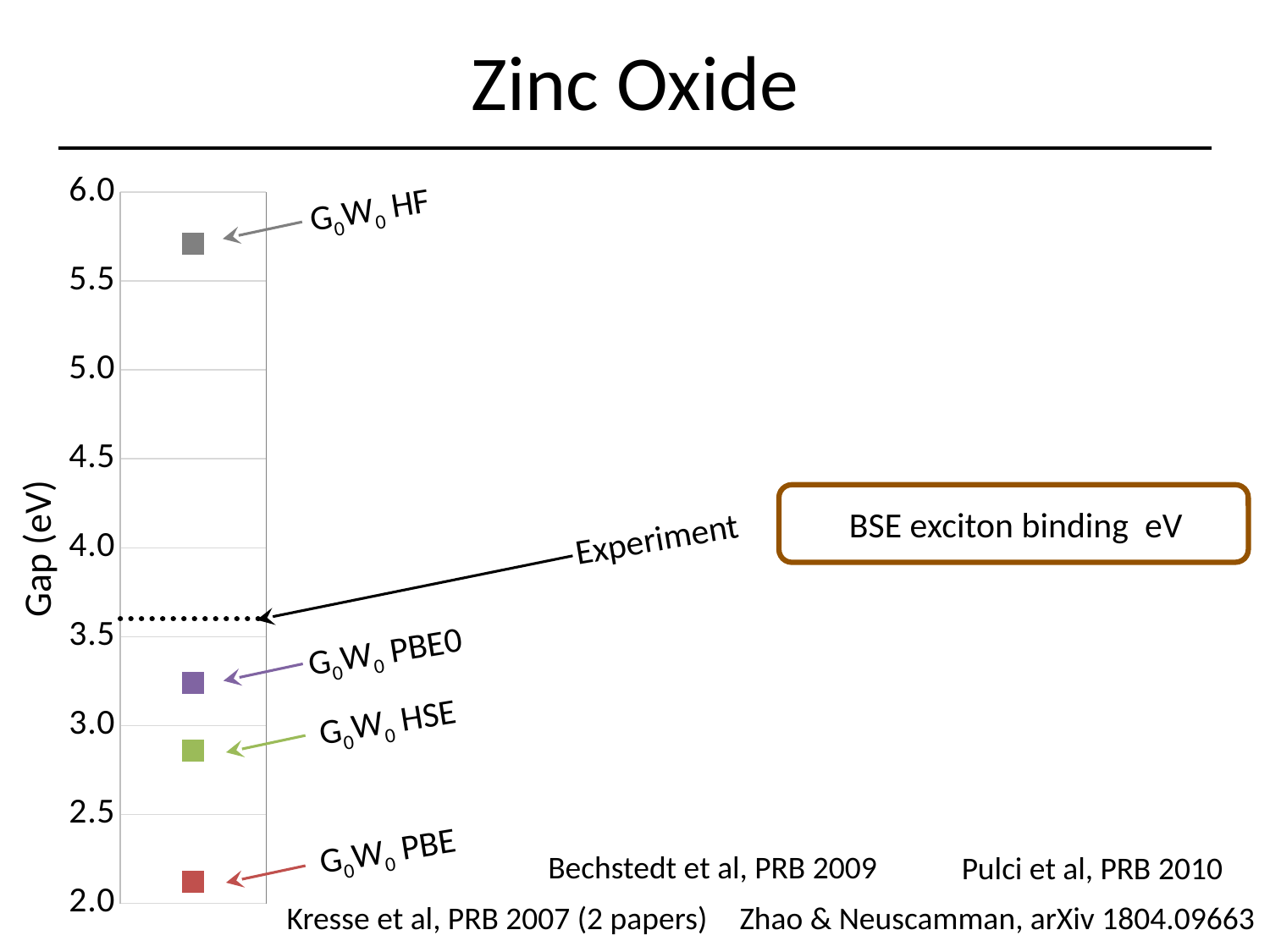
Is the gap value for G0W0 PBE0 greater or less than 3.5? less Is the gap value for G0W0 HF greater or less than 5.5? greater Which has a larger gap value, the Experiment line or G0W0 PBE0? Experiment Which method has the lowest gap value on the chart? G0W0 PBE Which method has the highest gap value on the chart? G0W0 HF Which has a larger gap value, G0W0 PBE0 or G0W0 HSE? G0W0 PBE0 How many G0W0 method data points are plotted on the chart? 4 Is the Experiment gap value greater or less than 3.5? greater What is the label of the vertical axis? Gap (eV) What is the title of the slide containing the chart? Zinc Oxide